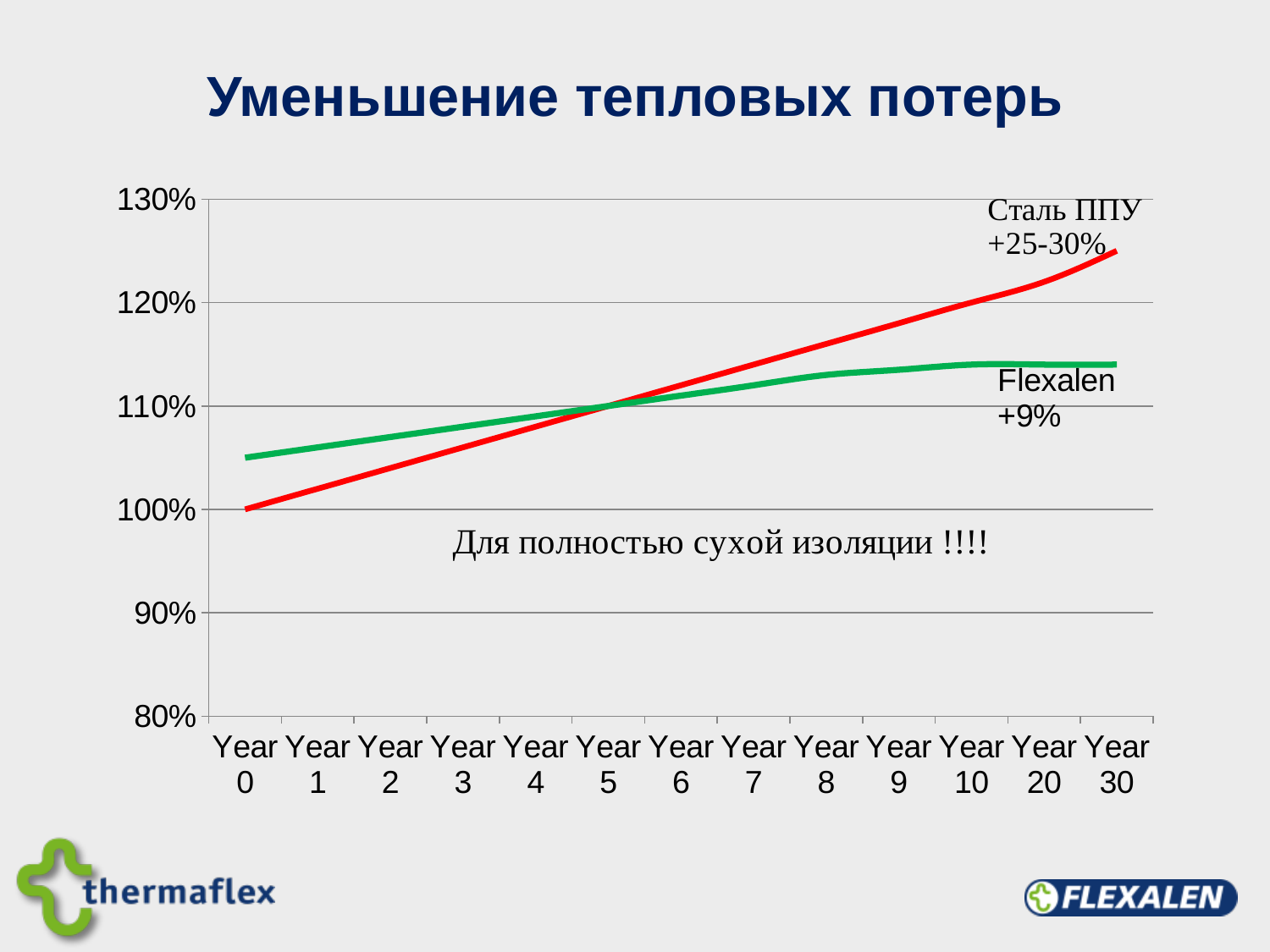
Does the Сталь ППУ line rise or fall from Year 0 to Year 30? rise Is the value of the Flexalen line at Year 30 greater or less than 120%? less Is the value of the Сталь ППУ line at Year 30 greater or less than 120%? greater What is the value of the Сталь ППУ line at Year 0? 100% At Year 30, which line is higher: Сталь ППУ or Flexalen? Сталь ППУ How many lines are plotted on the chart? 2 What kind of chart is shown on the slide? line chart Is the value of the Flexalen line at Year 0 greater or less than 100%? greater What is the title of the chart on the slide? Уменьшение тепловых потерь What colour is the Flexalen line? green How many year points are shown along the x axis? 13 At Year 0, which line is higher: Сталь ППУ or Flexalen? Flexalen